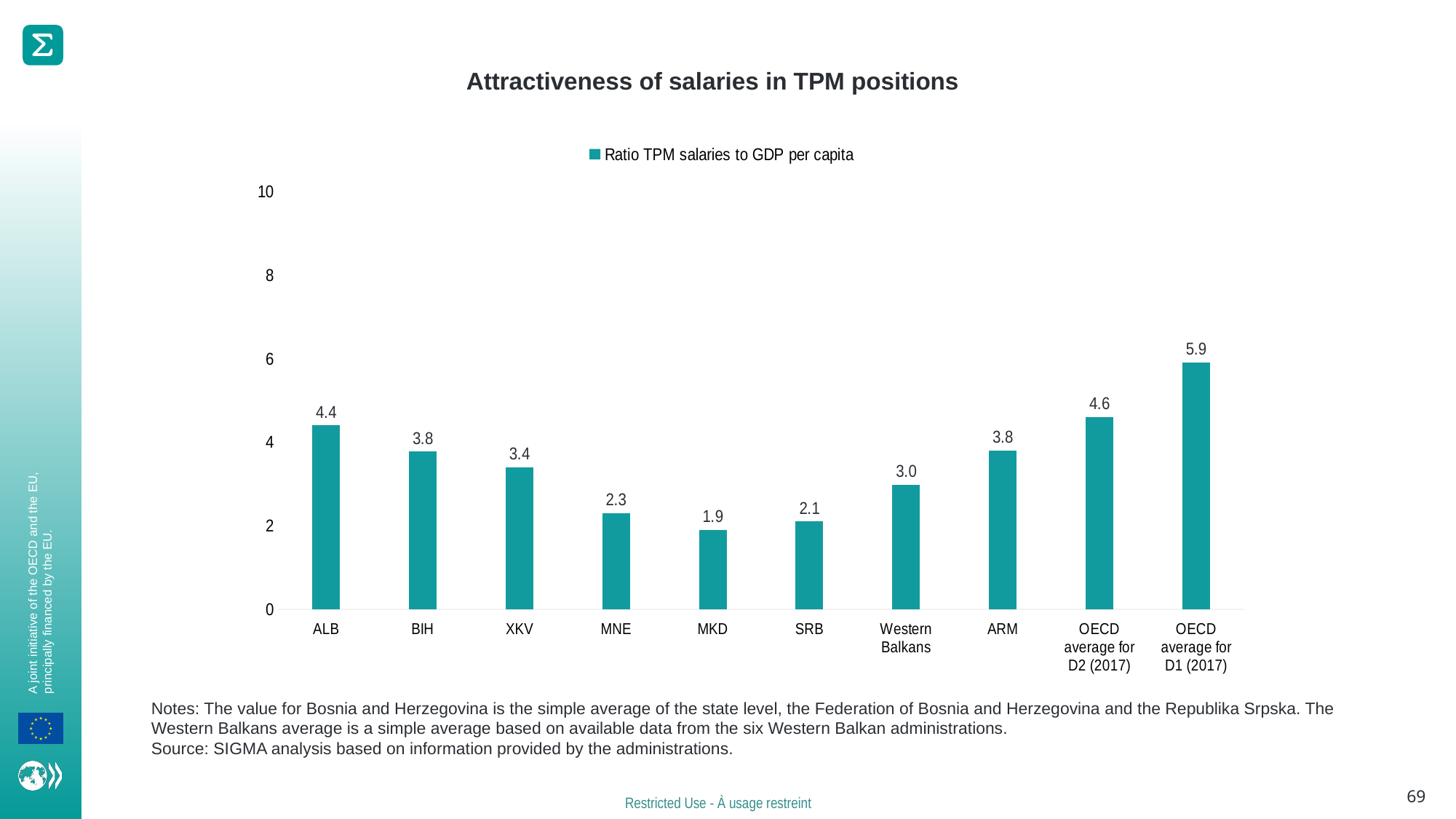
What is the title of the chart? Attractiveness of salaries in TPM positions How many series does the legend list? 1 What is the ratio of TPM salaries to GDP per capita for the Western Balkans? 3.0 Is the value for SRB greater or less than 4? less What is the value shown for the OECD average for D2 (2017)? 4.6 What kind of chart is shown on the slide? Bar chart Which category has the highest ratio of TPM salaries to GDP per capita? OECD average for D1 (2017) How many categories are shown on the x axis of the chart? 10 Which category has the lowest ratio of TPM salaries to GDP per capita? MKD Which has a higher ratio of TPM salaries to GDP per capita, XKV or MNE? XKV What is the ratio of TPM salaries to GDP per capita for ALB? 4.4 What is the difference between the values for OECD average for D1 (2017) and ALB? 1.5